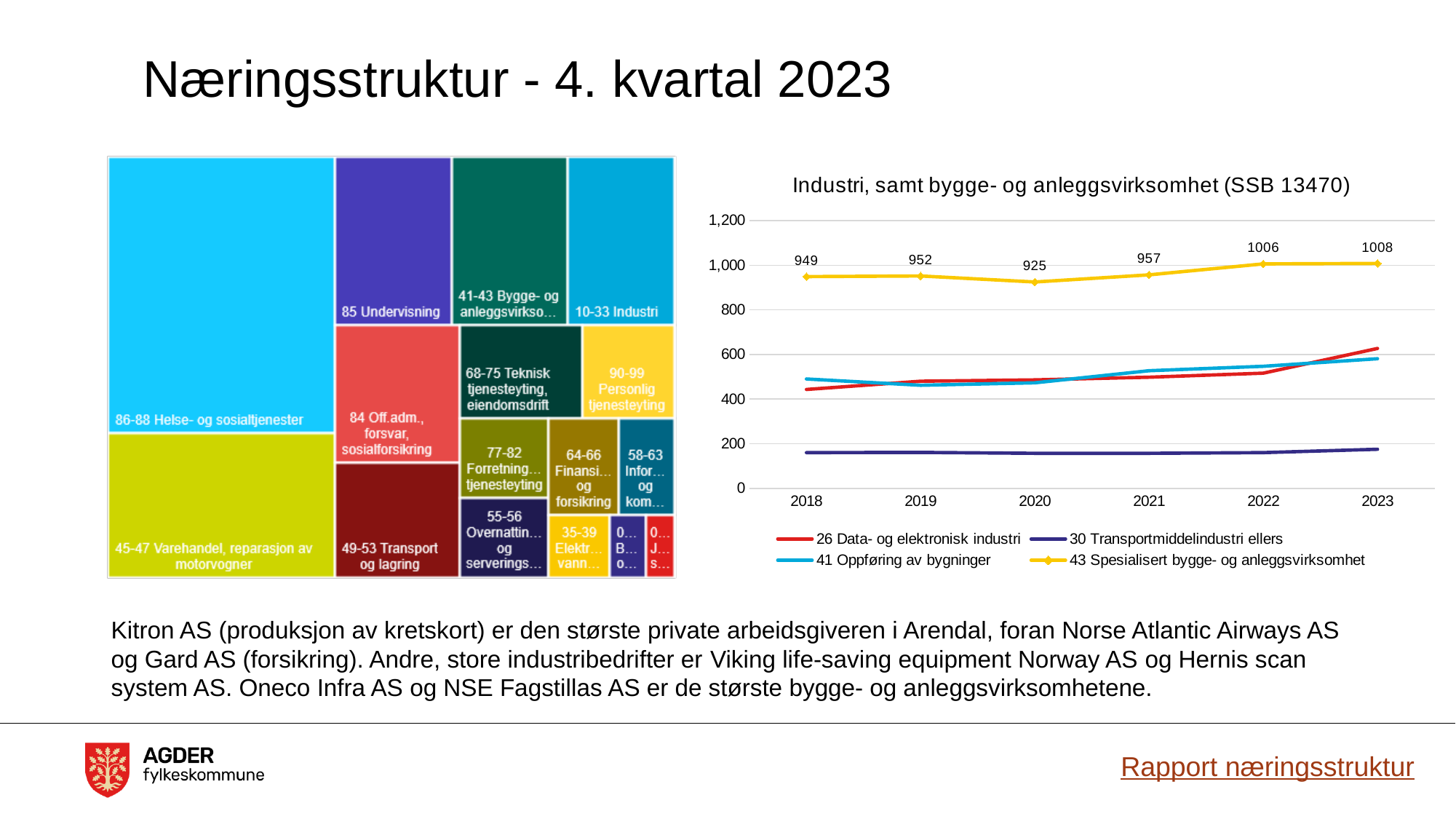
In the line chart on the right, what is the difference between the 2022 and 2021 values for 43 Spesialisert bygge- og anleggsvirksomhet? 49 In the line chart on the right, by how much did the value for 43 Spesialisert bygge- og anleggsvirksomhet increase from 2018 to 2023? 59 In the line chart on the right, which series is higher in 2023: 26 Data- og elektronisk industri or 41 Oppføring av bygninger? 26 Data- og elektronisk industri In the line chart on the right, is the value for 26 Data- og elektronisk industri in 2023 greater or less than 600? greater In the line chart 'Industri, samt bygge- og anleggsvirksomhet (SSB 13470)', what is the value for 43 Spesialisert bygge- og anleggsvirksomhet in 2020? 925 What kind of chart is the chart on the right of the slide? Line chart In the line chart on the right, is the value for 30 Transportmiddelindustri ellers in 2018 greater or less than 200? less In the line chart on the right, what is the value for 43 Spesialisert bygge- og anleggsvirksomhet in 2023? 1008 In the line chart on the right, in which year is the value for 43 Spesialisert bygge- og anleggsvirksomhet lowest? 2020 In the line chart on the right, in which year is the value for 43 Spesialisert bygge- og anleggsvirksomhet highest? 2023 How many years are shown on the x axis of the line chart on the right? 6 How many series does the legend of the line chart on the right list? 4